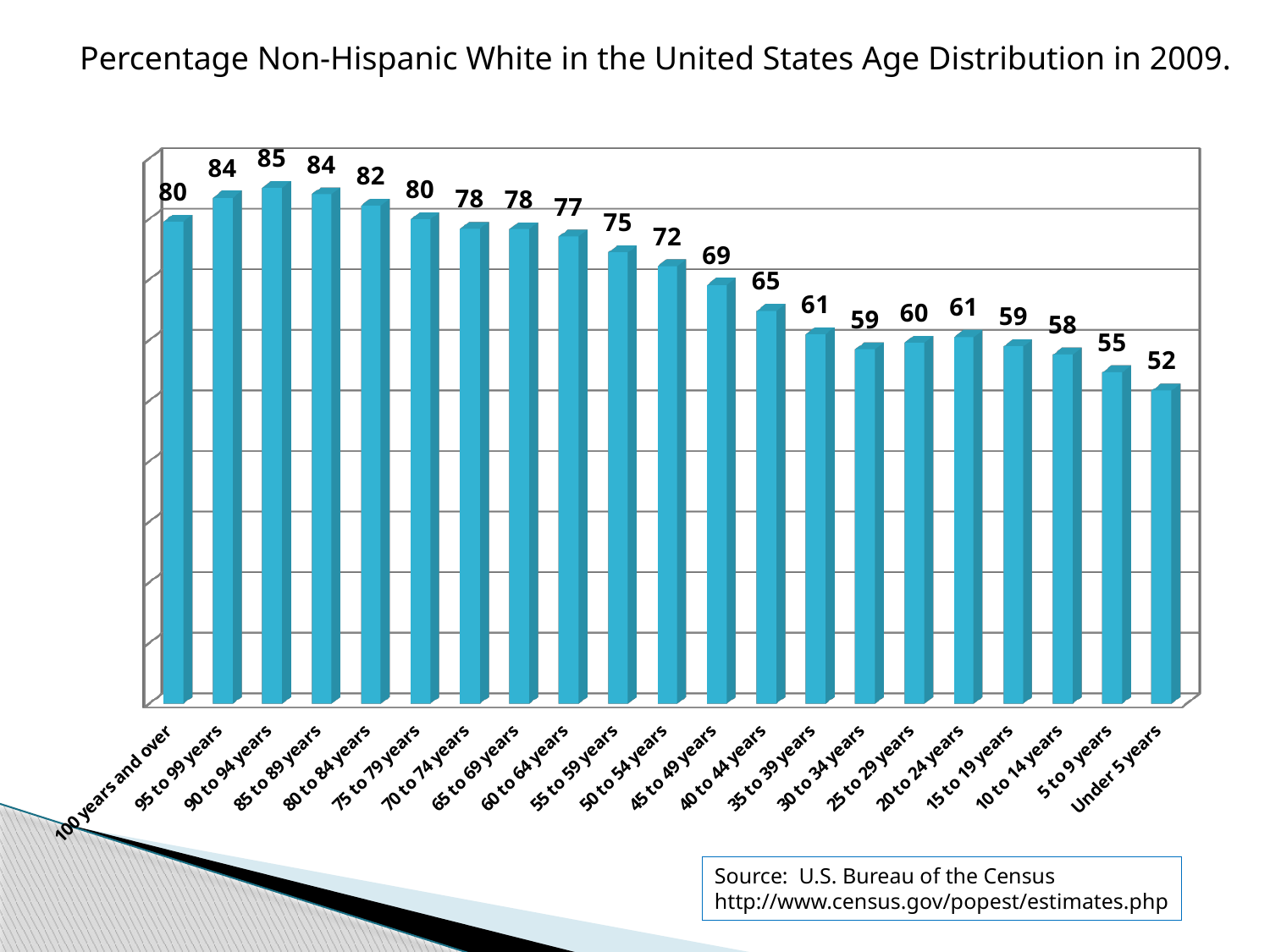
What kind of chart is shown on the slide? Bar chart How many age groups are shown in the chart? 21 What is the value for the 90 to 94 years age group? 85 Which is larger, the value for 80 to 84 years or the value for 50 to 54 years? 80 to 84 years Which age group has the highest value? 90 to 94 years Do the values generally rise or fall moving from the oldest age group on the left to the youngest on the right? Fall What is the value for the 45 to 49 years age group? 69 What is the value for the 100 years and over age group? 80 Which age group has the lowest value? Under 5 years What is the difference between the values for 90 to 94 years and Under 5 years? 33 What is the difference between the values for 55 to 59 years and 40 to 44 years? 10 What is the value for the Under 5 years age group? 52